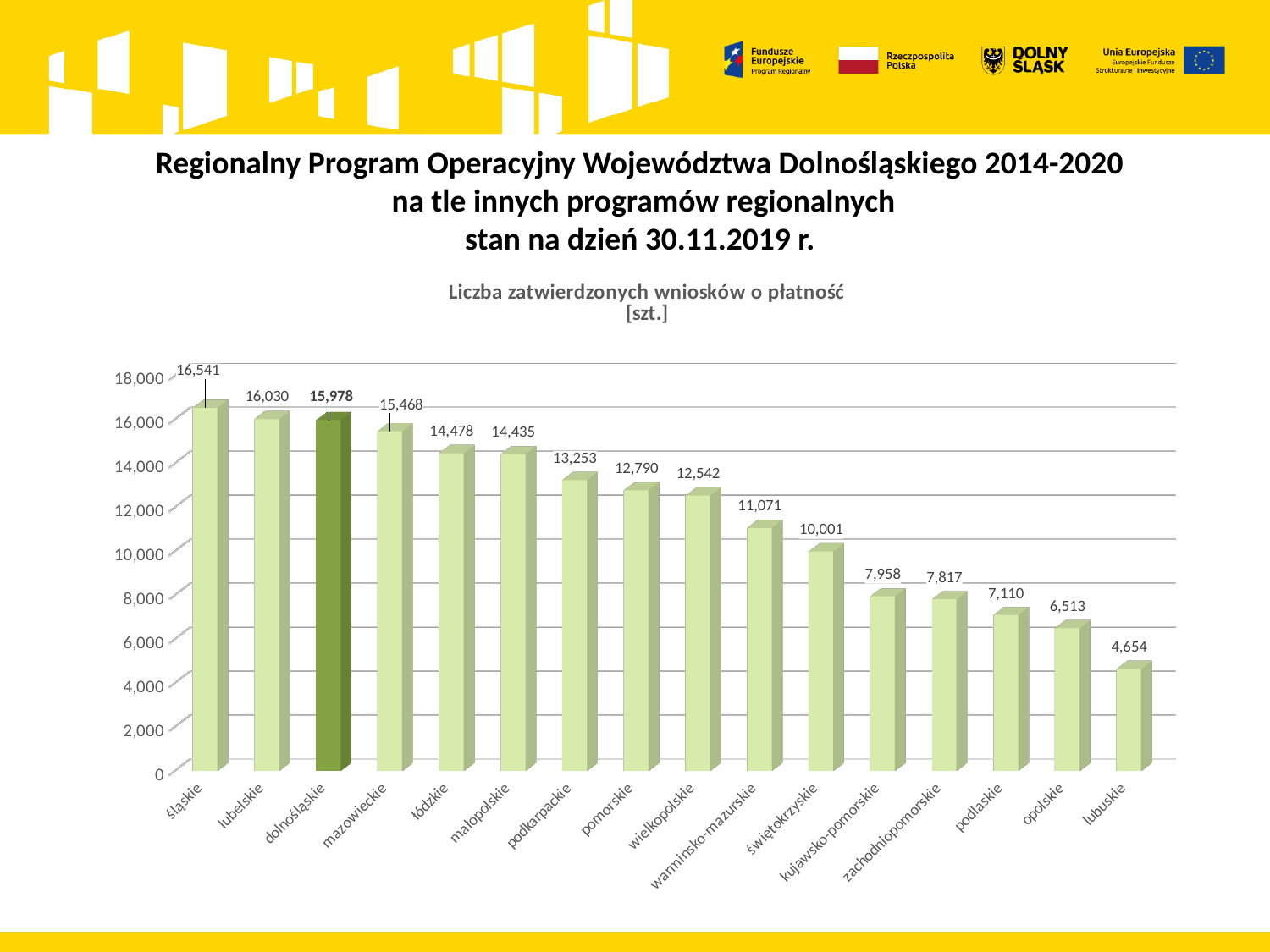
What is the value for dolnośląskie? 15,978 What is the value for pomorskie? 12,790 What kind of chart is this? bar chart Do the values rise or fall from left to right along the x axis? fall What is the difference between the values for śląskie and dolnośląskie? 563 Is the value for świętokrzyskie greater or less than 10,000? greater Which is larger, the value for małopolskie or the value for podkarpackie? małopolskie How many categories are shown on the x axis? 16 Which category has the highest value? śląskie What is the value for lubuskie? 4,654 Which category has the lowest value? lubuskie What is the title of the chart? Liczba zatwierdzonych wniosków o płatność [szt.]